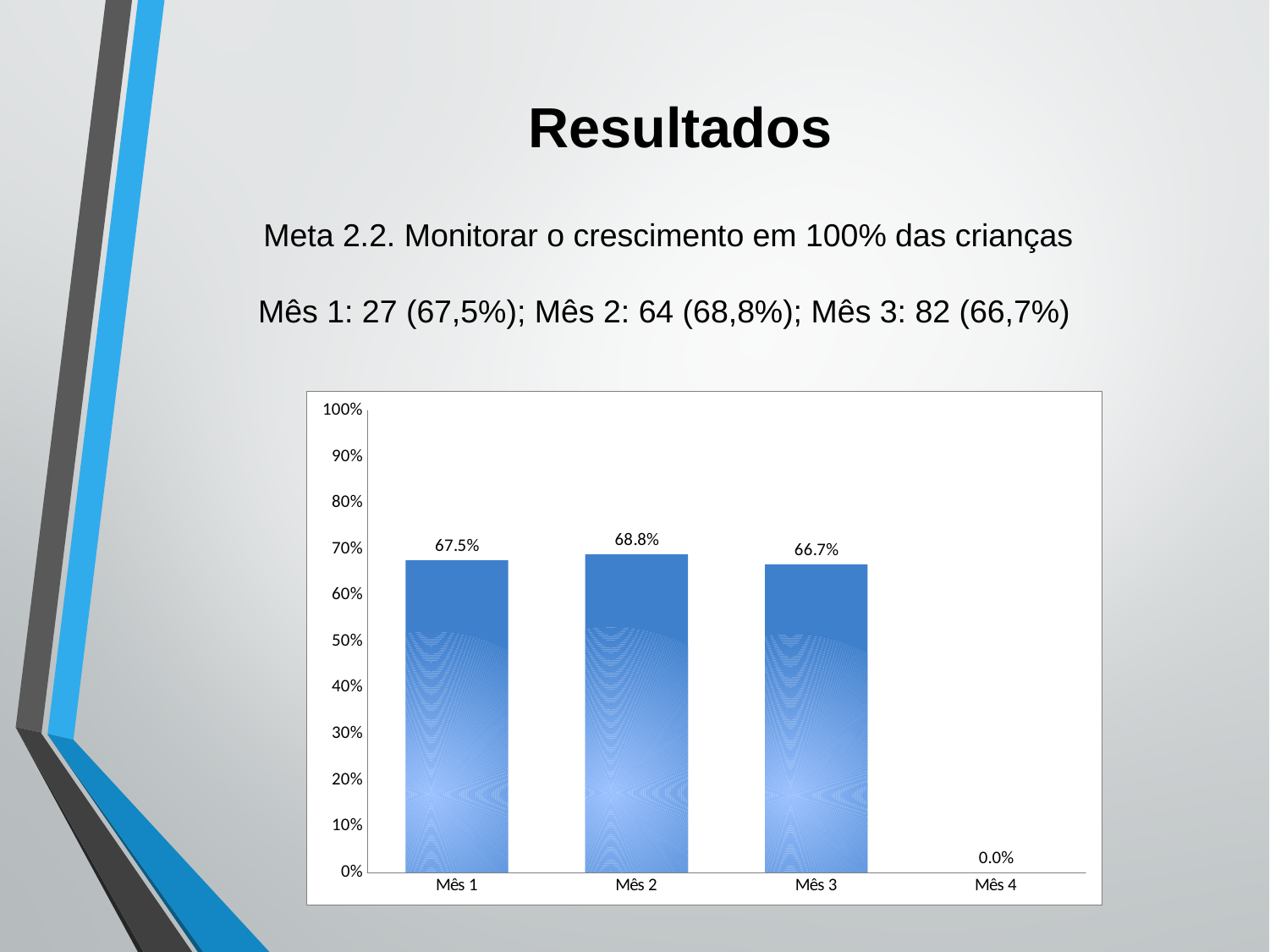
What is the value for Mês 3? 66.7% How many categories are shown on the x axis? 4 What is the value for Mês 2? 68.8% What is the value for Mês 1? 67.5% What is the difference between the values for Mês 2 and Mês 3? 2.1% Which is larger, the value for Mês 1 or the value for Mês 3? Mês 1 What is the highest value shown on the y axis? 100% What kind of chart is shown on the slide? bar chart What is the value for Mês 4? 0.0% Is the value for Mês 2 greater or less than 70%? less Which category has the highest value? Mês 2 Which category has the lowest value? Mês 4